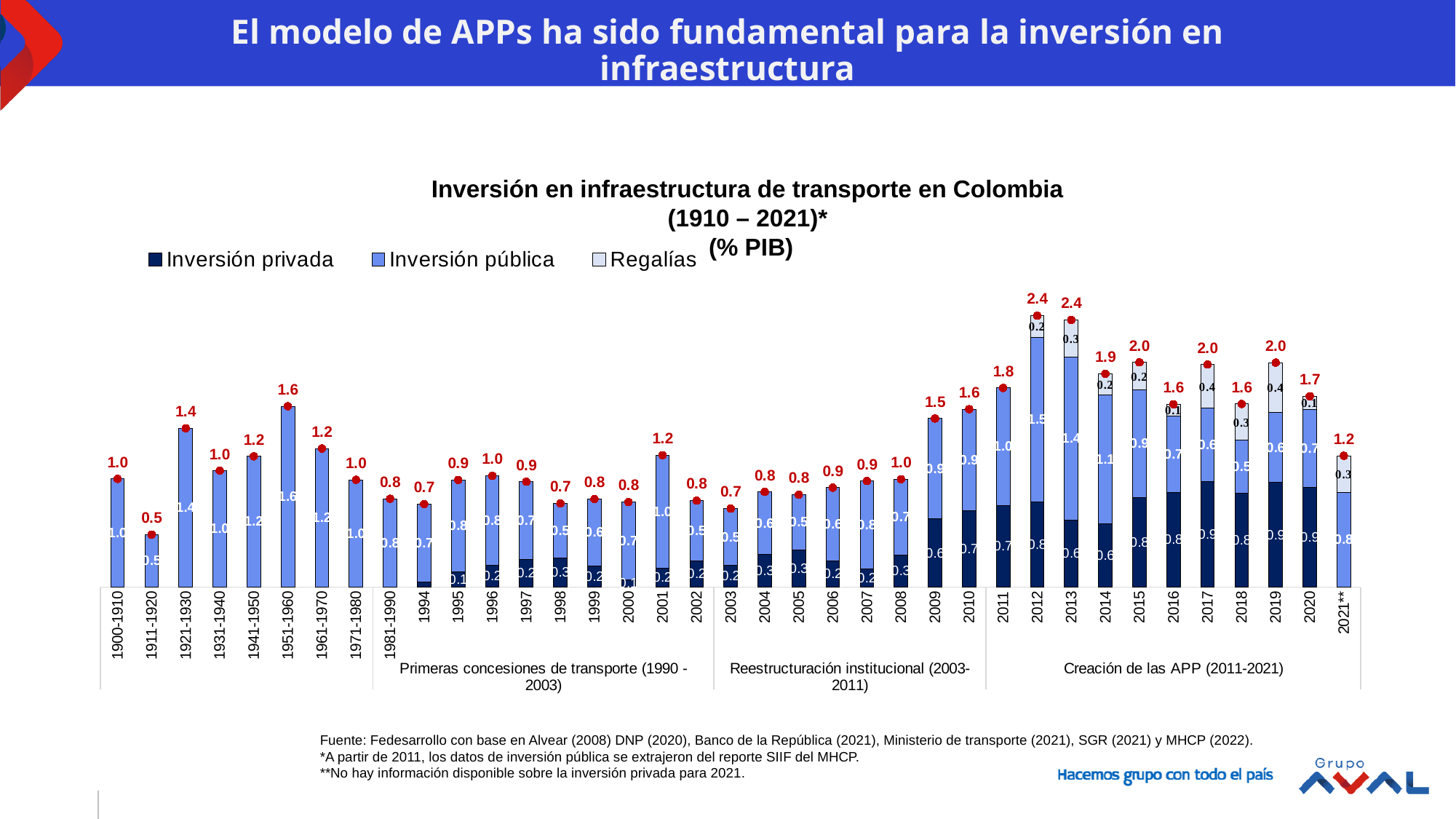
How many series does the legend list? 3 What is the total investment shown for 2012? 2.4 What are the three series listed in the legend? Inversión privada, Inversión pública, Regalías What kind of chart is shown on the slide? Stacked bar chart Which has a higher total investment, 2001 or 2002? 2001 What is the Inversión pública value for 2012? 1.5 What is the unit of measurement stated in the chart title? % PIB Which period has the lowest total investment? 1911-1920 What is the Inversión privada value for 2020? 0.9 What is the Regalías value for 2017? 0.4 What is the total investment (% PIB) shown for 1951-1960? 1.6 What is the difference between the total investment in 2013 and in 2021**? 1.2